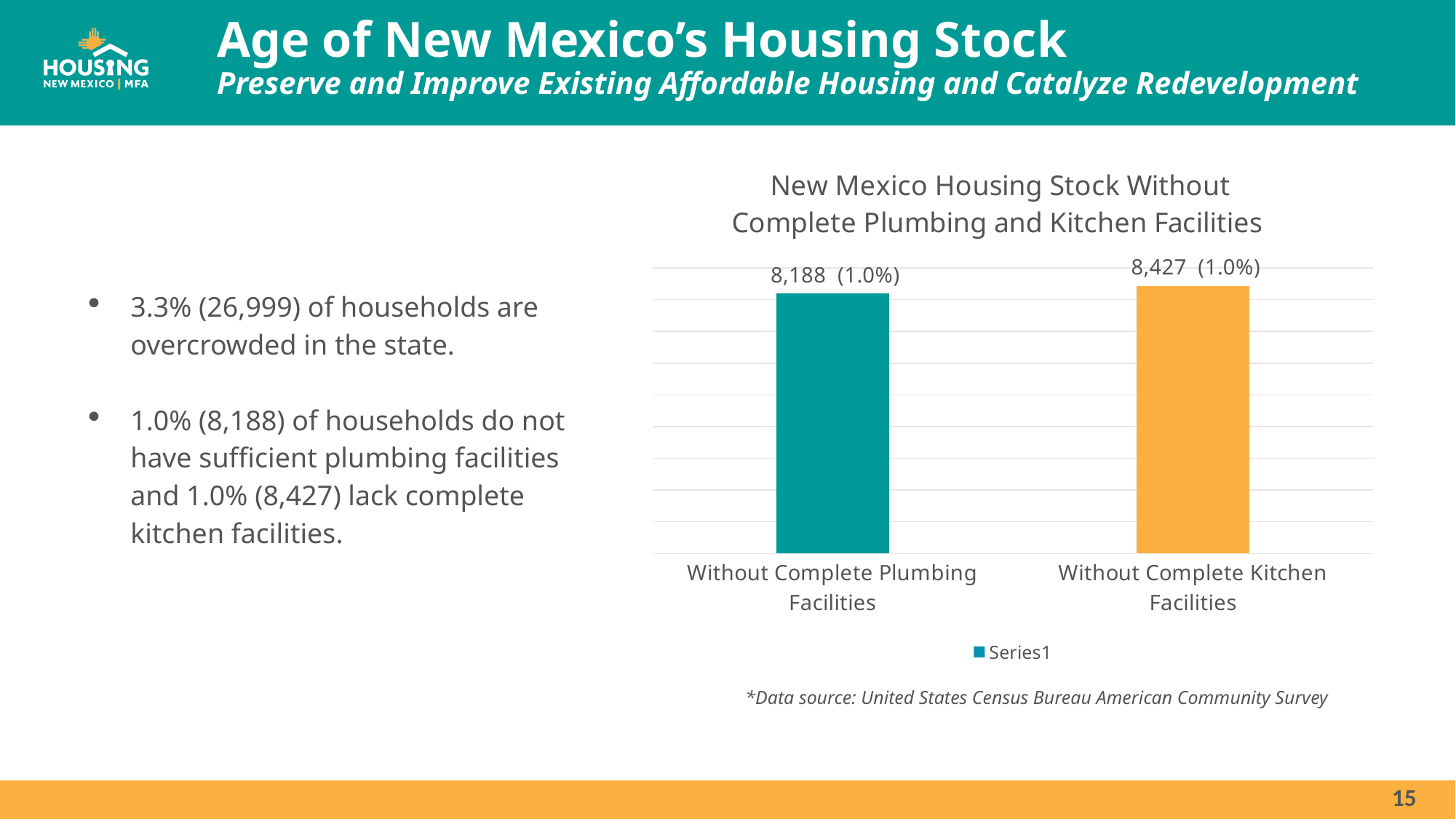
What is the value shown for Without Complete Plumbing Facilities? 8,188 What kind of chart is shown on the slide? Bar chart How many categories are plotted in the chart? 2 What is the title of the chart? New Mexico Housing Stock Without Complete Plumbing and Kitchen Facilities Is the value for Without Complete Plumbing Facilities larger or smaller than the value for Without Complete Kitchen Facilities? Smaller Which category has the lower value in the chart? Without Complete Plumbing Facilities What percentage is shown on the data label for Without Complete Kitchen Facilities? 1.0% Which category has the higher value in the chart? Without Complete Kitchen Facilities How many series does the chart legend list? 1 What is the name of the series shown in the chart legend? Series1 What is the difference between the values for Without Complete Kitchen Facilities and Without Complete Plumbing Facilities? 239 What is the value shown for Without Complete Kitchen Facilities? 8,427